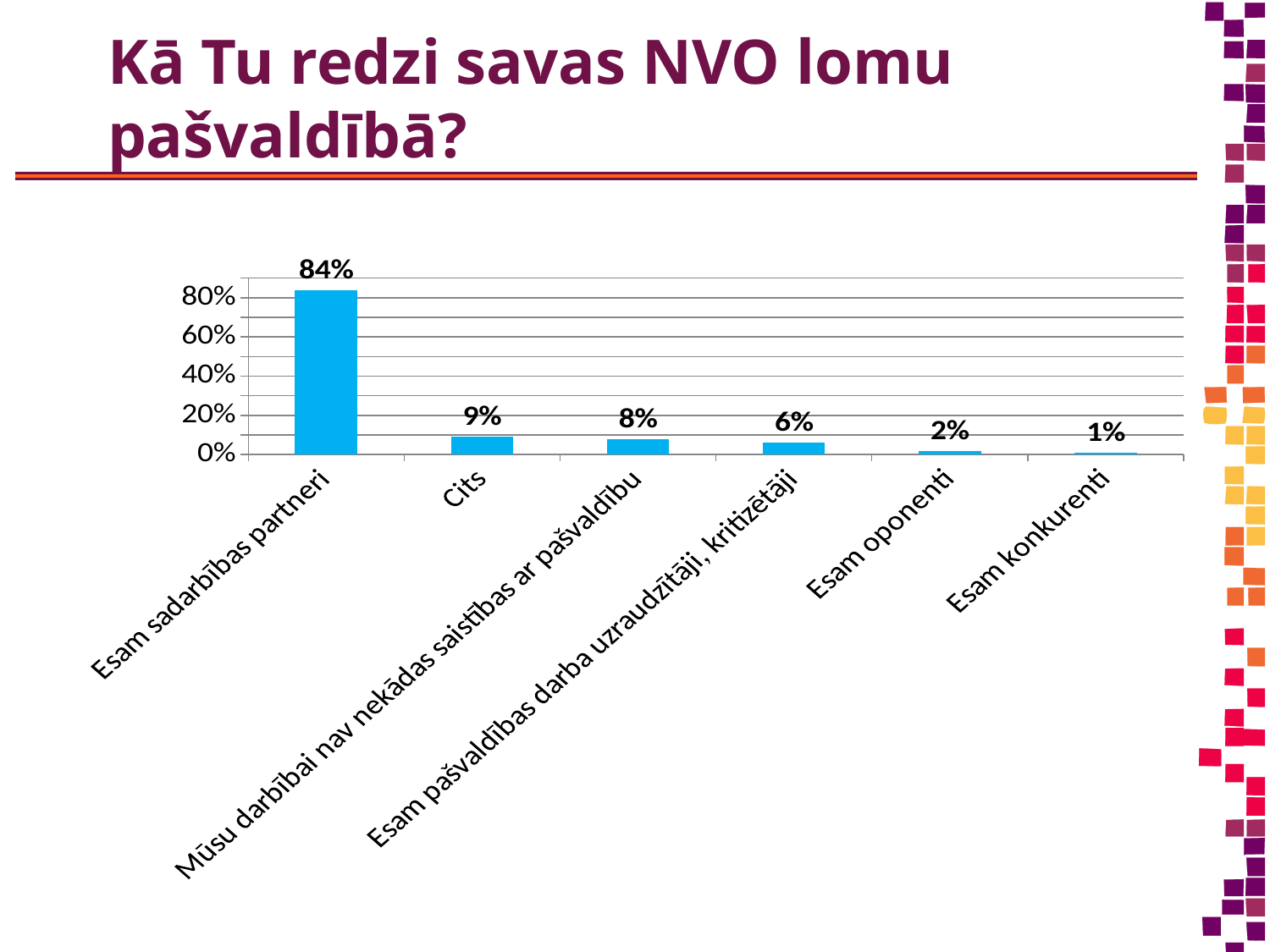
Is the value for "Esam sadarbības partneri" greater or less than 60%? greater What is the difference between the values for "Esam sadarbības partneri" and "Cits"? 75% What is the value for "Esam sadarbības partneri"? 84% How many categories are shown on the x axis? 6 What is the value for "Esam pašvaldības darba uzraudzītāji, kritizētāji"? 6% What is the value for "Cits"? 9% What kind of chart is shown on the slide? bar chart What is the value for "Esam konkurenti"? 1% Which category has the lowest value? Esam konkurenti What is the difference between the values for "Mūsu darbībai nav nekādas saistības ar pašvaldību" and "Esam oponenti"? 6% Which is larger, the value for "Cits" or the value for "Esam oponenti"? Cits Which category has the highest value? Esam sadarbības partneri